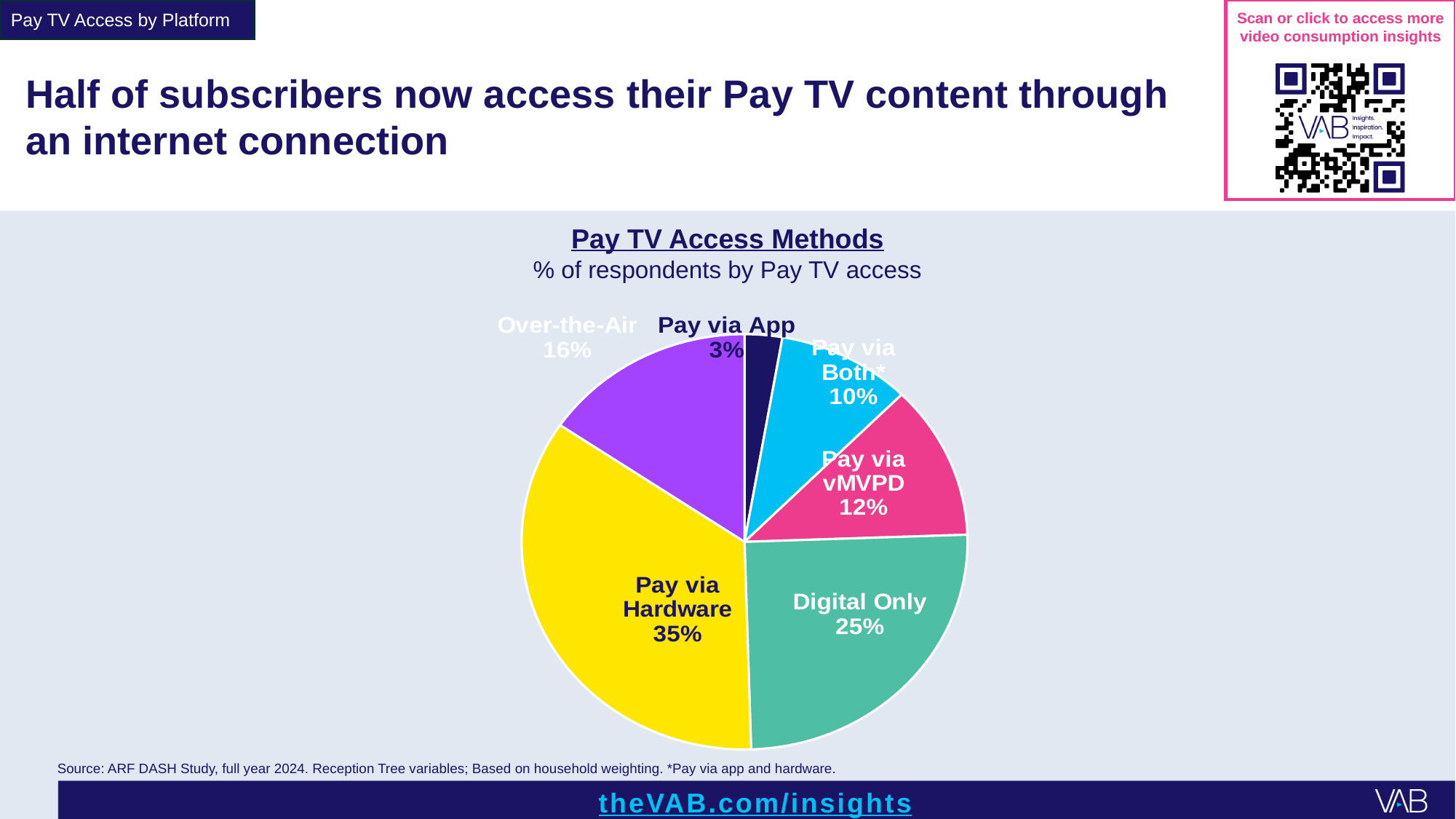
What is the difference between the Pay via Hardware share and the Digital Only share? 10% What percentage of respondents access Pay TV via App? 3% What is the combined share of Pay via Both* and Pay via App? 13% Which access method has the largest share of the pie? Pay via Hardware What percentage of respondents access Pay TV via Hardware? 35% What is the title of the chart? Pay TV Access Methods What kind of chart is shown on the slide? Pie chart What percentage of respondents access Pay TV via vMVPD? 12% Which access method has the smallest share of the pie? Pay via App How many slices does the pie chart have? 6 What percentage of respondents are Digital Only? 25% Which is larger, the Over-the-Air share or the Pay via vMVPD share? Over-the-Air